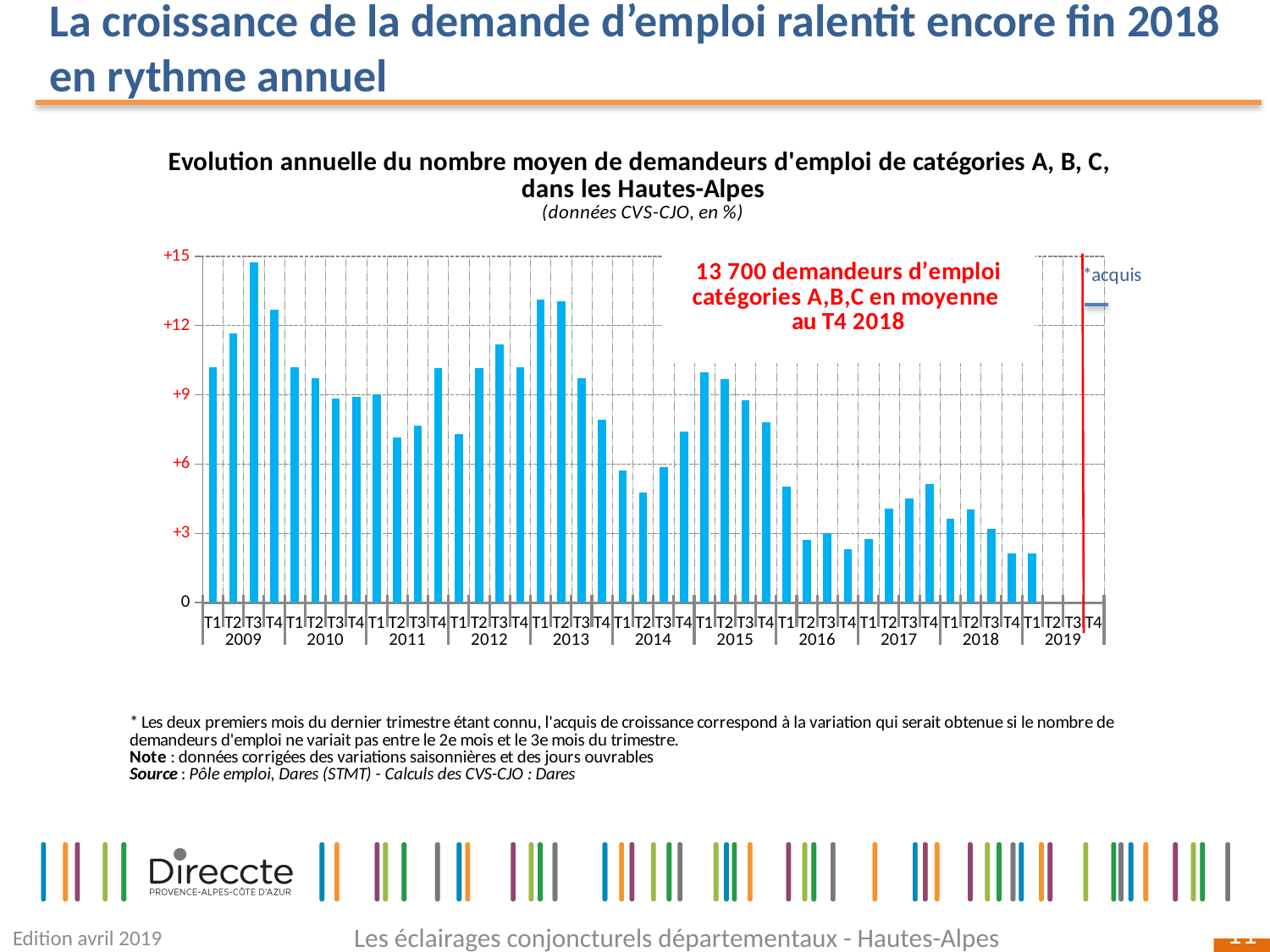
Is the value for T2 2012 greater or less than 9? greater What kind of chart is shown on the slide? bar chart Is the value for T3 2009 greater or less than 12? greater In what unit are the data in the chart expressed, according to the subtitle? en % Is the value for T1 2013 greater or less than 12? greater Do the values rise or fall from T1 2015 to T4 2016? fall Which quarter has the highest value in the chart? T3 2009 How many years are labelled on the x axis? 11 Which is larger, the value for T1 2015 or the value for T1 2017? T1 2015 According to the annotation on the chart, how many job seekers in categories A, B, C were there on average in T4 2018? 13 700